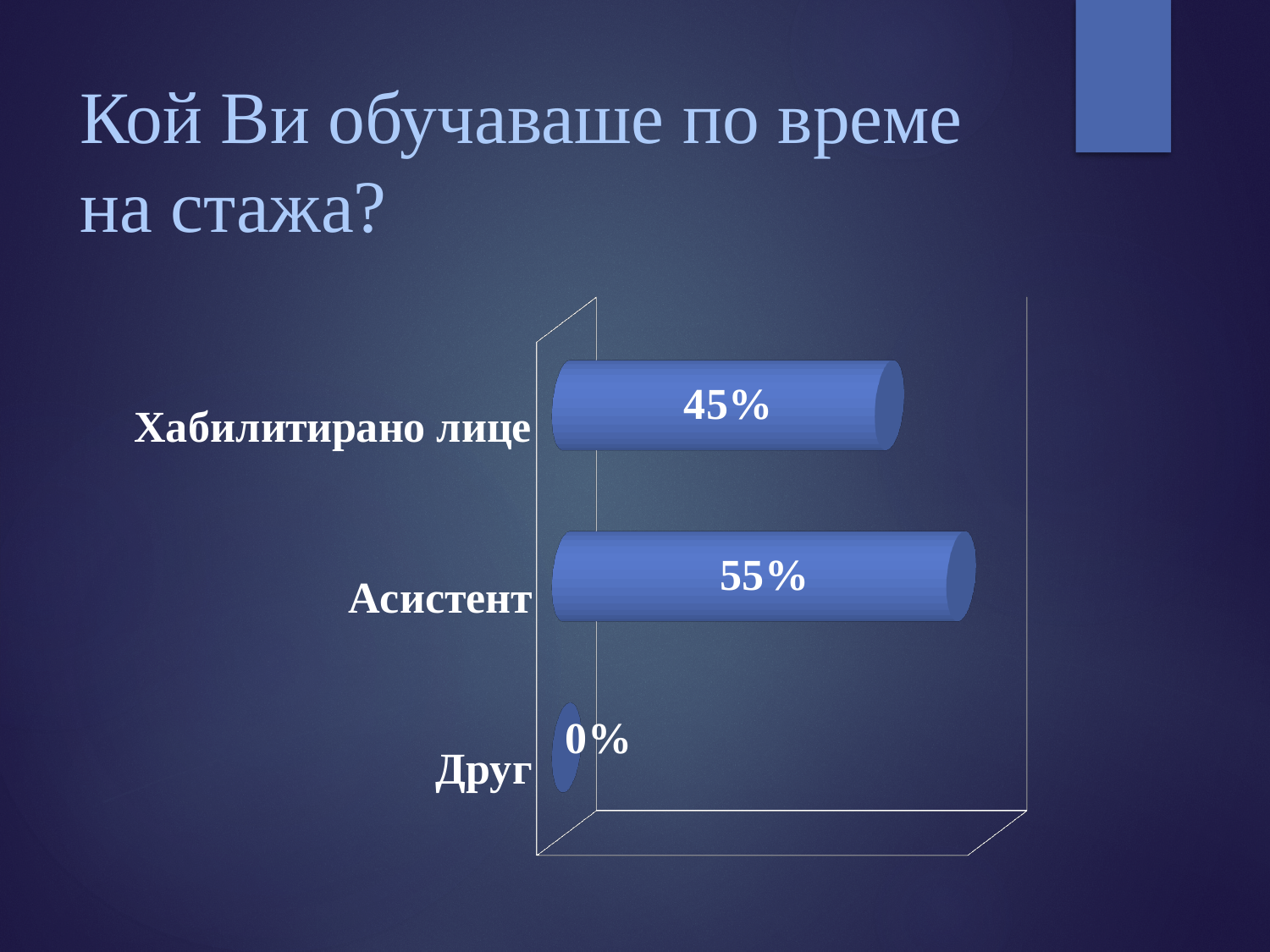
What is the title of the slide containing the chart? Кой Ви обучаваше по време на стажа? What is the value for Друг? 0% What is the value for Хабилитирано лице? 45% Which category has the highest value? Асистент How many categories are shown in the chart? 3 What is the value for Асистент? 55% What is the difference between the values for Асистент and Хабилитирано лице? 10% Which category has the lowest value? Друг Which is larger, the value for Хабилитирано лице or the value for Асистент? Асистент What kind of chart is shown on the slide? bar chart What colour are the bars in the chart? blue